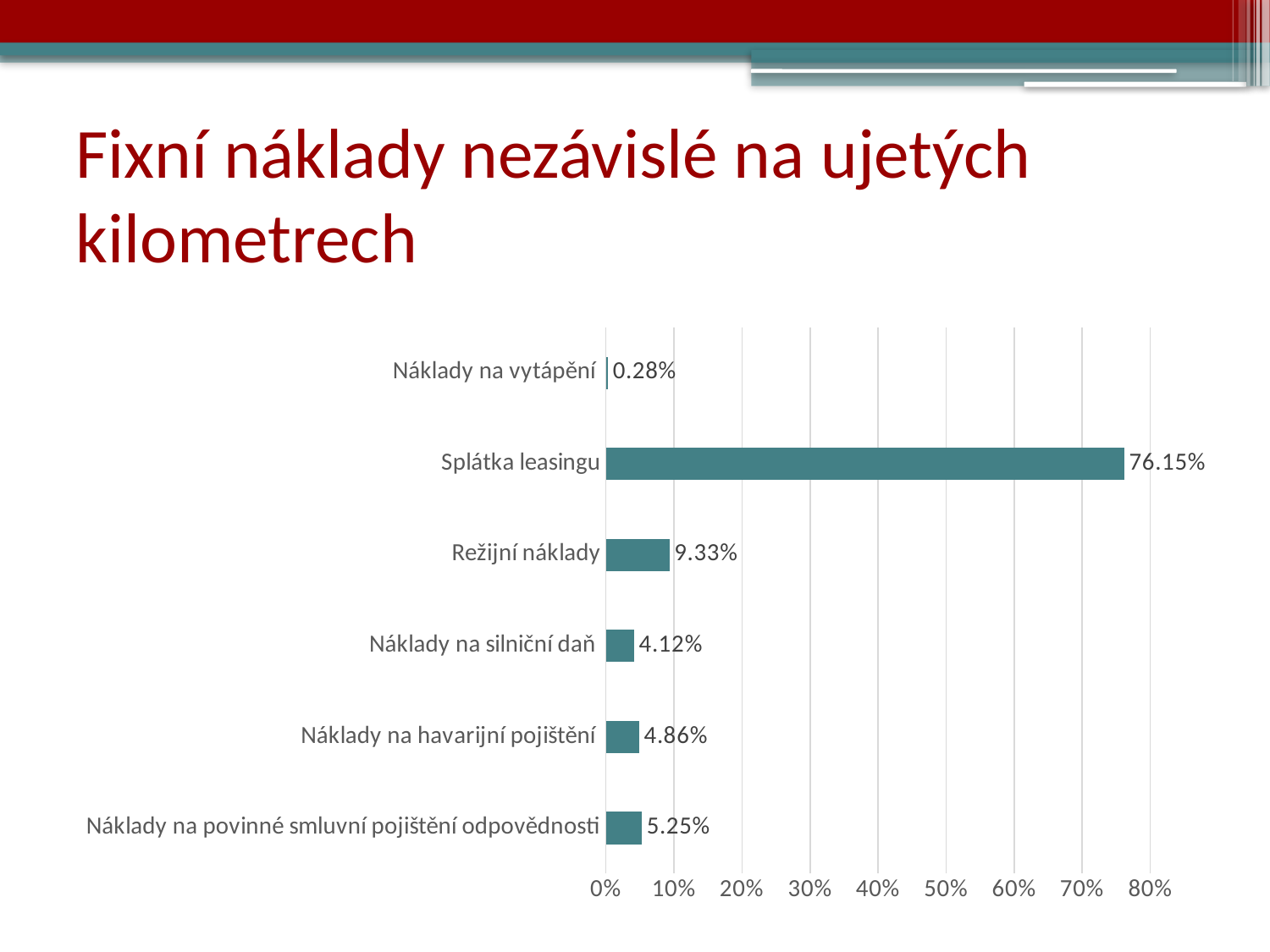
Is the value for Splátka leasingu greater or less than 70%? greater How many categories are shown in the chart? 6 What is the value for Náklady na silniční daň? 4.12% What is the difference between Splátka leasingu and Režijní náklady? 66.82% What is the value for Náklady na vytápění? 0.28% What kind of chart is shown on the slide? bar chart What is the value for Režijní náklady? 9.33% Which category has the lowest value? Náklady na vytápění What is the title of the slide? Fixní náklady nezávislé na ujetých kilometrech Which category has the highest value? Splátka leasingu Which is larger, Náklady na havarijní pojištění or Náklady na silniční daň? Náklady na havarijní pojištění What is the value for Splátka leasingu? 76.15%